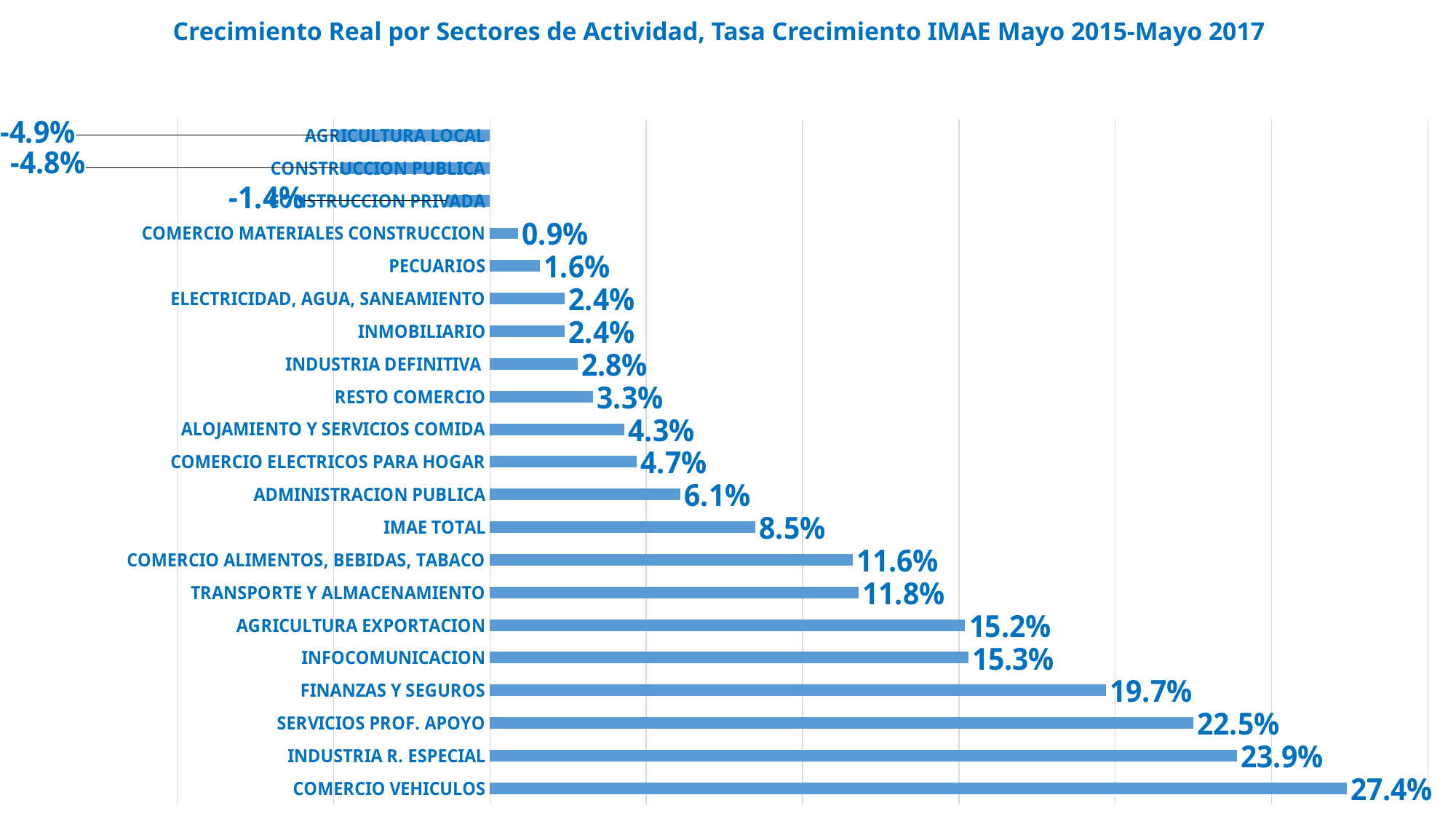
What is the difference between the values for COMERCIO VEHICULOS and INDUSTRIA R. ESPECIAL? 3.5% Which is larger, the value for AGRICULTURA EXPORTACION or the value for TRANSPORTE Y ALMACENAMIENTO? AGRICULTURA EXPORTACION What is the title of the chart? Crecimiento Real por Sectores de Actividad, Tasa Crecimiento IMAE Mayo 2015-Mayo 2017 Which sector has the highest growth rate? COMERCIO VEHICULOS What is the growth rate shown for COMERCIO VEHICULOS? 27.4% What is the value shown for AGRICULTURA LOCAL? -4.9% What is the value shown for IMAE TOTAL? 8.5% What is the difference between the values for IMAE TOTAL and ADMINISTRACION PUBLICA? 2.4% Which sector has the lowest growth rate? AGRICULTURA LOCAL What is the value shown for FINANZAS Y SEGUROS? 19.7% What kind of chart is shown on the slide? Bar chart How many sectors are plotted in the chart? 21